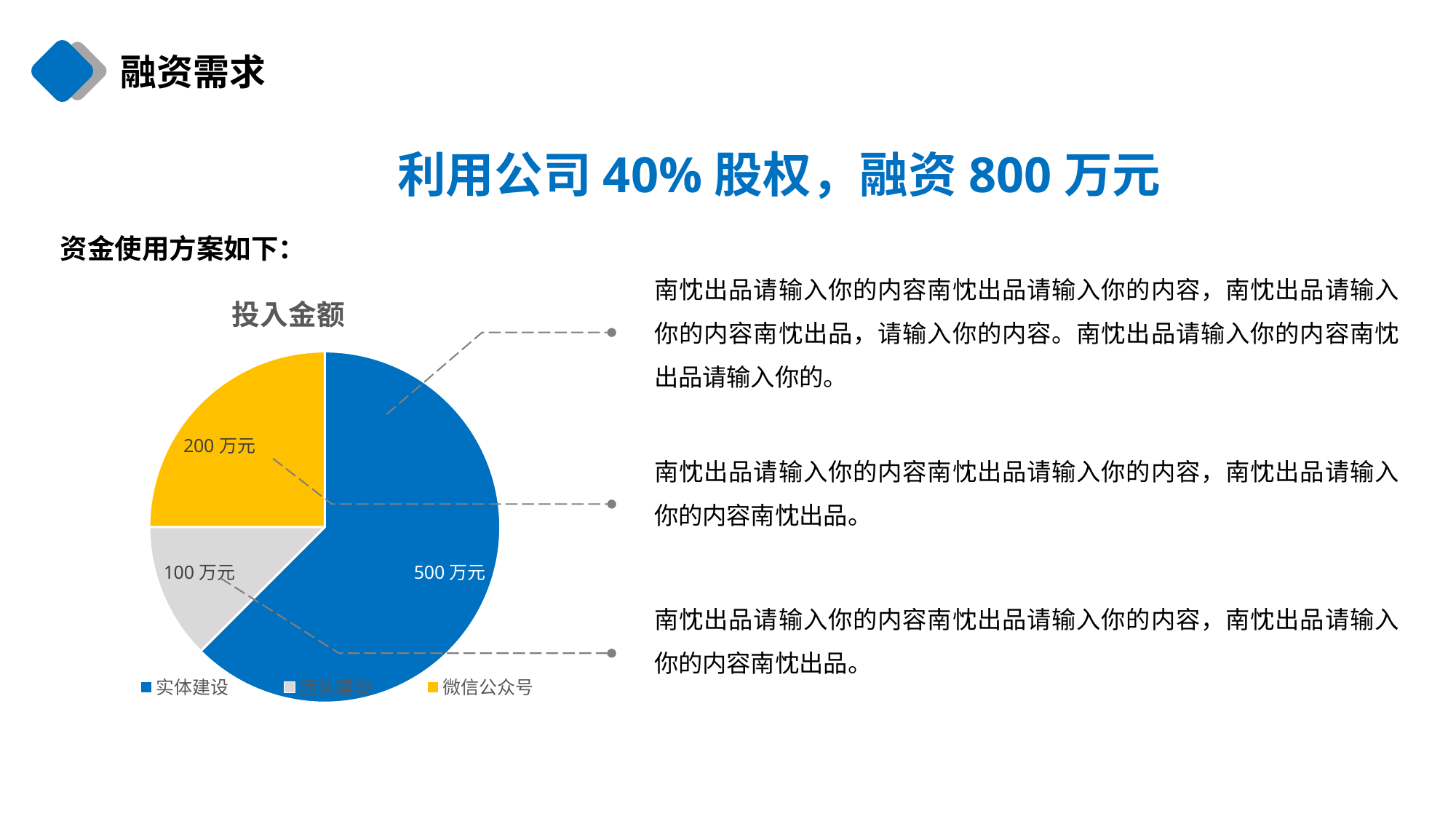
What is the difference between the values for 实体建设 and 微信公众号? 300 万元 Which is larger, the value for 微信公众号 or the value for 团队建设? 微信公众号 What is the value for 实体建设 in the pie chart? 500 万元 Which category has the largest slice in the pie chart? 实体建设 What share of the pie does the 实体建设 slice represent? 62.5% How many slices does the pie chart have? 3 What is the title of the pie chart? 投入金额 How many entries does the legend of the pie chart list? 3 What is the value for 团队建设 in the pie chart? 100 万元 What kind of chart is shown on the slide? Pie chart Which category has the smallest slice in the pie chart? 团队建设 What is the value for 微信公众号 in the pie chart? 200 万元